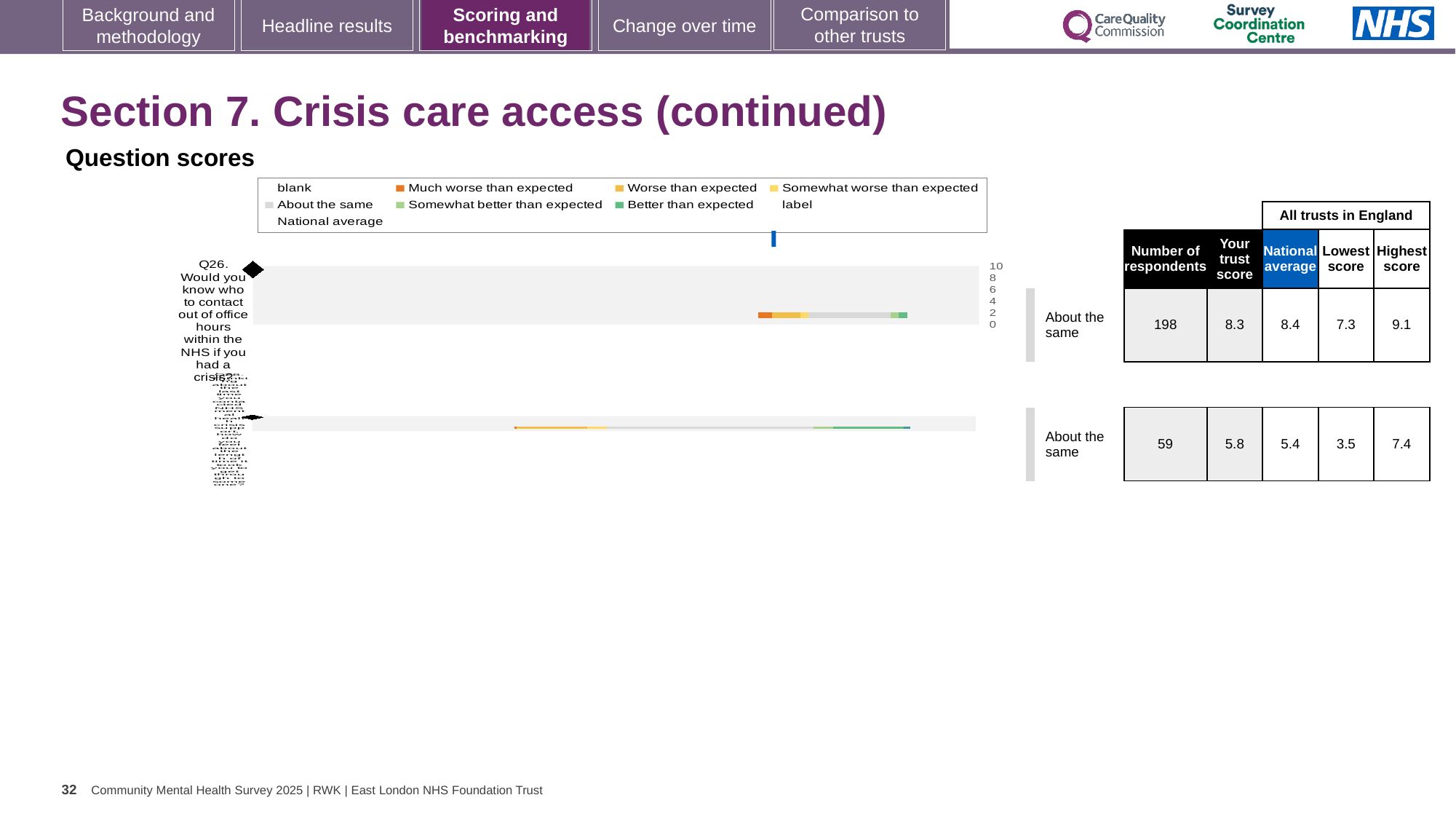
What is the highest score among all trusts in England for Q26? 9.1 In the legend, what colour represents 'Better than expected'? Green By how much does the national average exceed the trust score for Q26? 0.1 For Q26, which is larger: the trust score or the national average? National average What benchmark category is shown for Q26? About the same What is the lowest score among all trusts in England for Q26? 7.3 What is the difference between the highest and lowest trust scores in England for Q26? 1.8 What is the national average score for Q26? 8.4 What kind of chart is used to show the question scores? Bar chart How many respondents answered Q26? 198 What is the trust score for Q26 (Would you know who to contact out of office hours within the NHS if you had a crisis?)? 8.3 In the legend, what colour represents 'Much worse than expected'? Orange